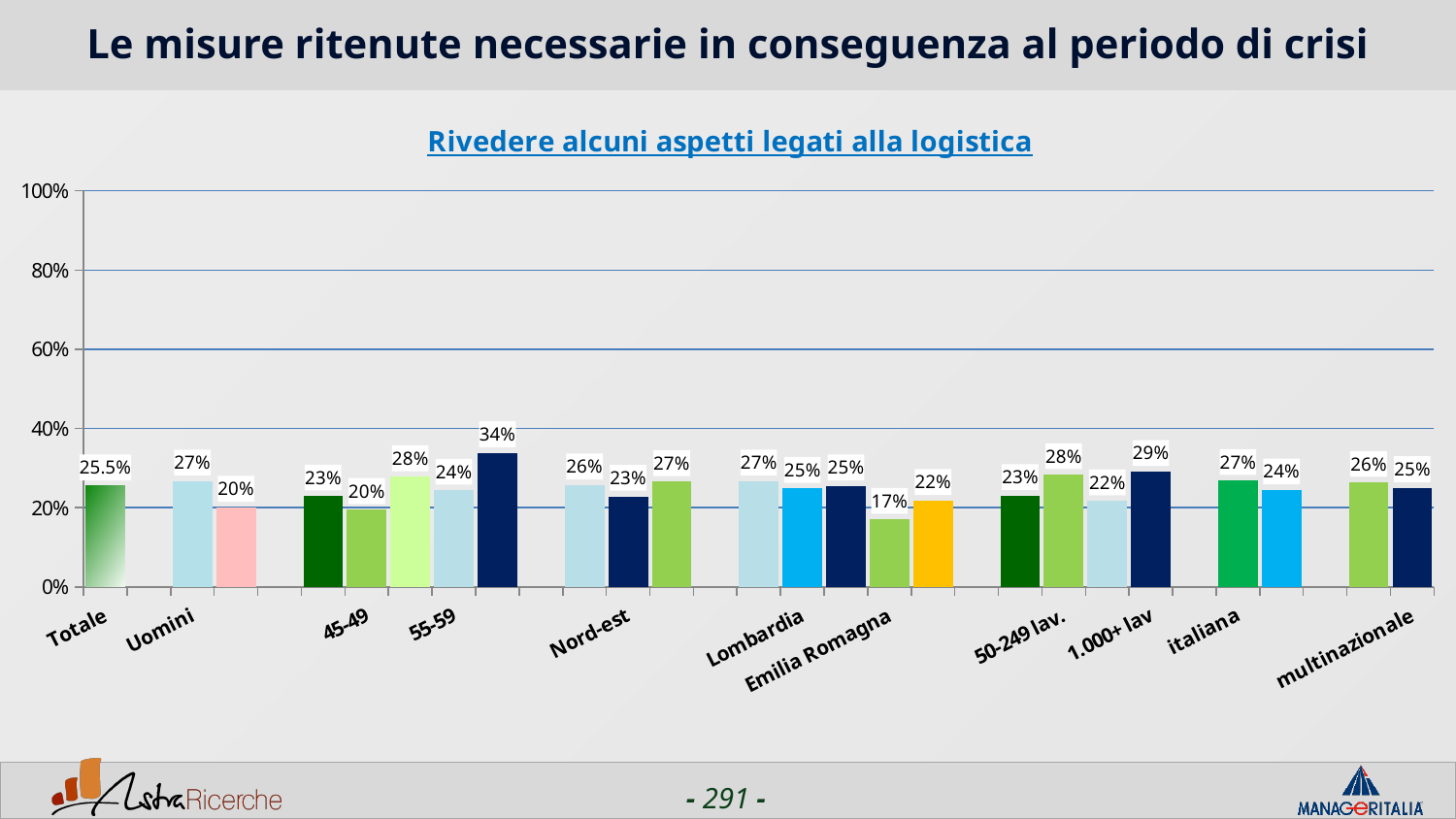
Is the value for Totale greater or less than 40%? less What is the lowest value shown by any bar in the chart? 17% Is the value for Uomini greater or less than 20%? greater What is the value for Uomini? 27% What is the value for Totale? 25.5% What type of chart is shown on the slide? bar chart What is the highest value shown by any bar in the chart? 34% What is the difference between the value for Uomini and the value for Totale? 1.5% What is the title of the chart? Rivedere alcuni aspetti legati alla logistica Which is larger, the value for Uomini or the value for Totale? Uomini How many bars are plotted in the chart? 24 What is the maximum value shown on the vertical axis? 100%